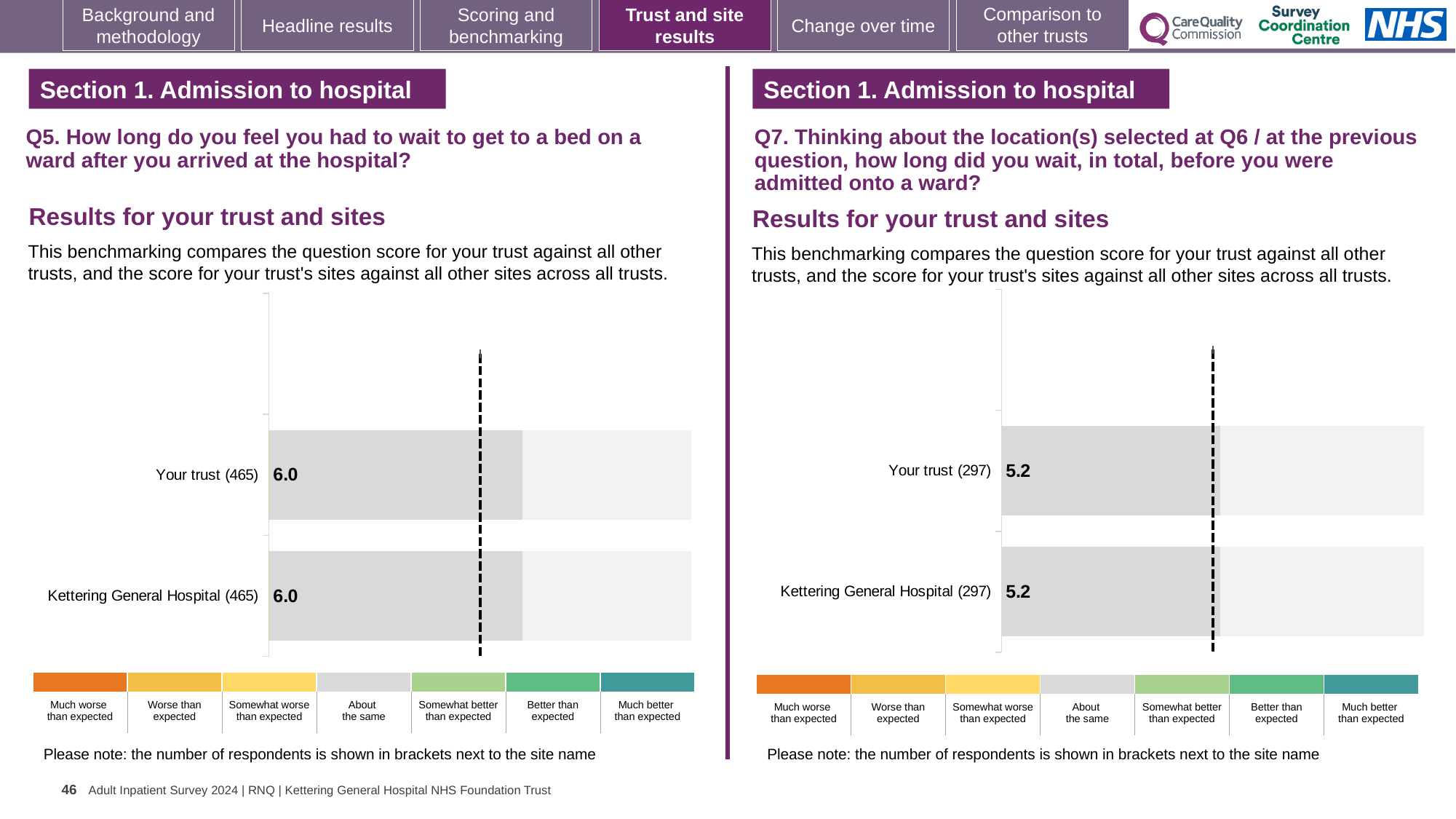
How many bars are plotted on the Q7 chart (right)? 2 On the Q5 chart (left), what is the score for Kettering General Hospital? 6.0 On the Q7 chart (right), what is the score for Kettering General Hospital? 5.2 On the Q7 chart (right), what is the score for Your trust? 5.2 What kind of chart is used on the Q5 chart (left)? bar chart On the Q7 chart (right), which site is listed below Your trust? Kettering General Hospital Is the score for Your trust on the Q5 chart (left) larger or smaller than the score for Your trust on the Q7 chart (right)? larger On the Q5 chart (left), how many respondents are shown in brackets for Your trust? 465 On the Q5 chart (left), what is the difference between the score for Your trust and the score for Kettering General Hospital? 0.0 On the Q7 chart (right), how many respondents are shown in brackets for Kettering General Hospital? 297 On the Q5 chart (left), what is the score for Your trust? 6.0 How many benchmark categories are listed in the colour key below the Q5 chart (left)? 7